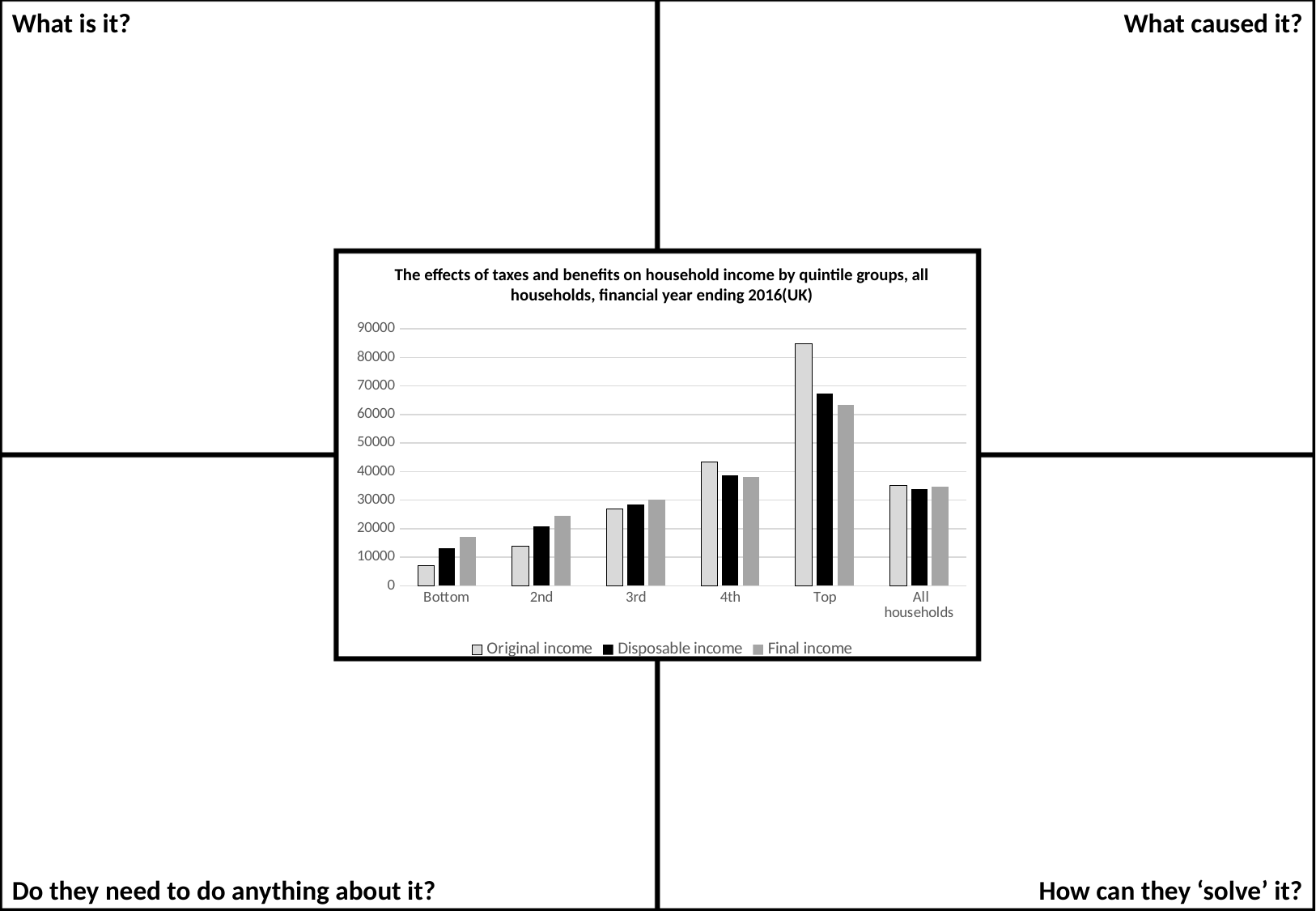
What kind of chart is shown on the slide? bar chart For the Bottom quintile, which is larger: Original income or Final income? Final income Is the Disposable income value for the Top quintile greater or less than 60000? greater Is the Original income value for the Top quintile greater or less than 80000? greater Does Original income rise or fall from the Bottom quintile to the Top quintile? rise Which category has the highest Original income? Top Is the Final income value for the Bottom quintile greater or less than 20000? less How many series does the chart's legend list? 3 For the Top quintile, which is larger: Original income or Disposable income? Original income What are the three series listed in the chart's legend? Original income, Disposable income, Final income Which category has the lowest Original income? Bottom How many categories are shown along the x axis of the chart? 6